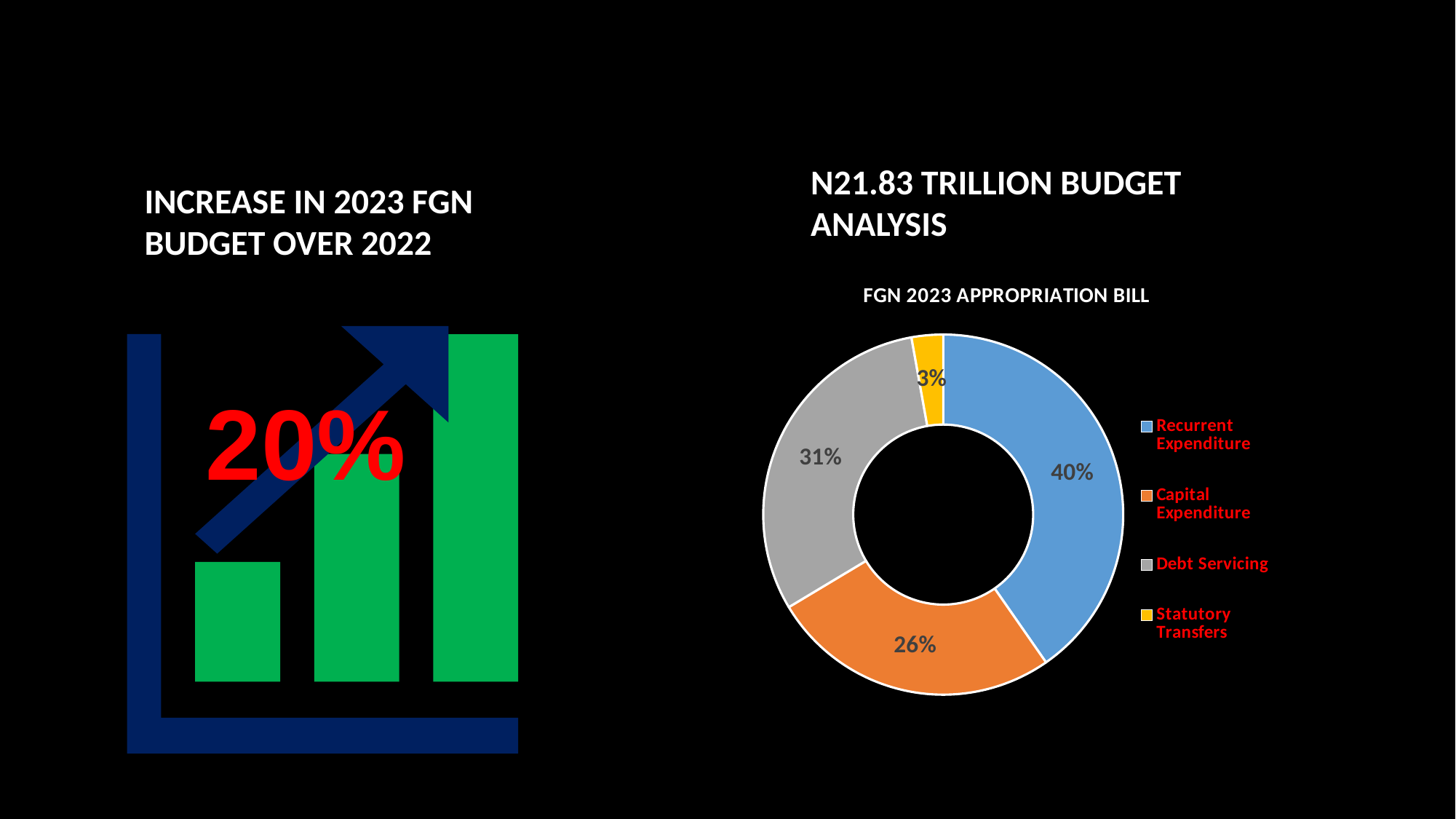
In the FGN 2023 Appropriation Bill chart, which category has the largest share? Recurrent Expenditure In the FGN 2023 Appropriation Bill chart, what share is Capital Expenditure? 26% How many categories does the FGN 2023 Appropriation Bill chart show? 4 In the FGN 2023 Appropriation Bill chart, what share is Debt Servicing? 31% In the FGN 2023 Appropriation Bill chart, what share is Recurrent Expenditure? 40% In the FGN 2023 Appropriation Bill chart, what is the difference in percentage points between Recurrent Expenditure and Capital Expenditure? 14 percentage points In the FGN 2023 Appropriation Bill chart, which is larger: Debt Servicing or Capital Expenditure? Debt Servicing In the FGN 2023 Appropriation Bill chart, what colour is the Debt Servicing slice? Grey What kind of chart is the FGN 2023 Appropriation Bill chart? Doughnut (pie) chart In the FGN 2023 Appropriation Bill chart, which category has the smallest share? Statutory Transfers What is the title of the chart on the right side of the slide? FGN 2023 APPROPRIATION BILL In the FGN 2023 Appropriation Bill chart, what share is Statutory Transfers? 3%